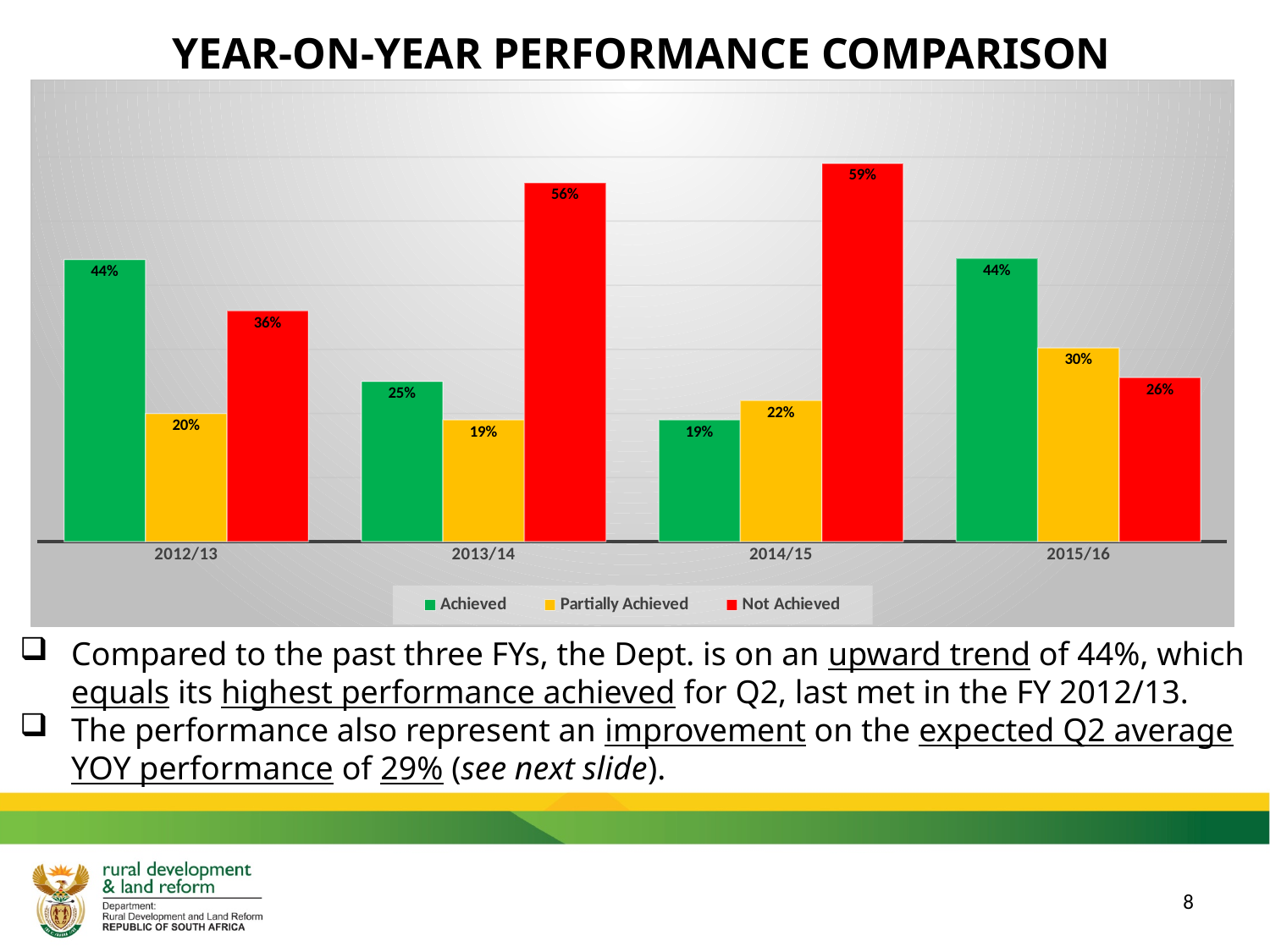
How many series does the legend list? 3 What is the difference between the Not Achieved values for 2013/14 and 2015/16? 30% What is the Achieved value for 2013/14? 25% Which year has the lowest Achieved value? 2014/15 What is the Partially Achieved value for 2015/16? 30% What colour represents the Not Achieved series? Red Which year has the highest Not Achieved value? 2014/15 What is the Not Achieved value for 2014/15? 59% Does the Partially Achieved value rise or fall from 2014/15 to 2015/16? Rise Which is larger, the Achieved value for 2012/13 or the Not Achieved value for 2012/13? Achieved value for 2012/13 What kind of chart is shown on the slide? Bar chart How many years are shown on the x axis? 4